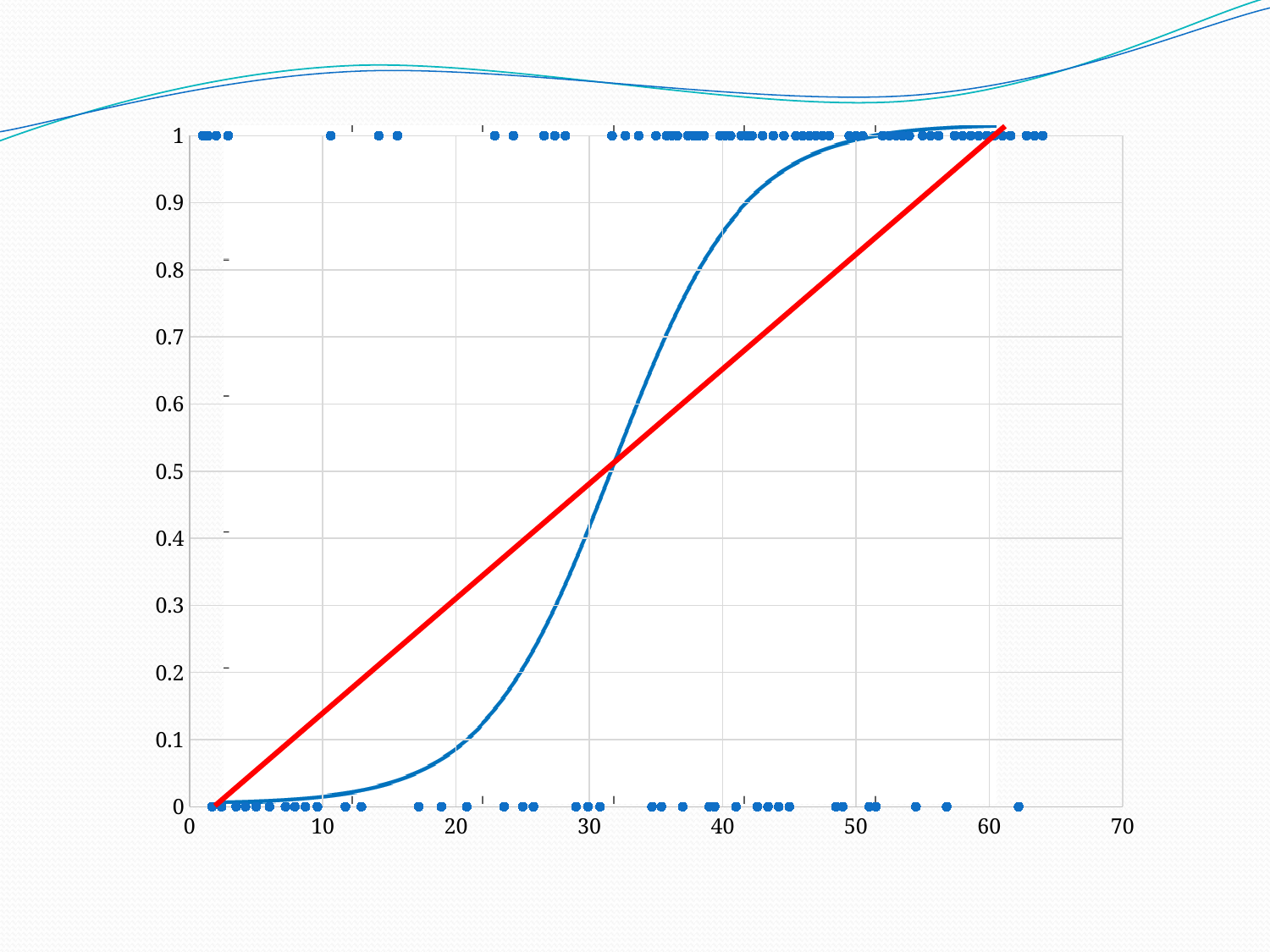
Is the value of the blue curve at x = 10 greater or less than 0.1? less What is the highest value labelled on the x axis? 70 Does the blue S-shaped curve rise or fall as x increases from 0 to 60? rise What kind of chart is shown on the slide? scatter chart At x = 40, which is higher: the blue curve or the red line? the blue curve Is the value of the red line at x = 10 greater or less than 0.5? less Is the value of the blue curve at x = 20 greater or less than 0.5? less At x = 20, which is higher: the blue curve or the red line? the red line Does the red straight line rise or fall as x increases? rise